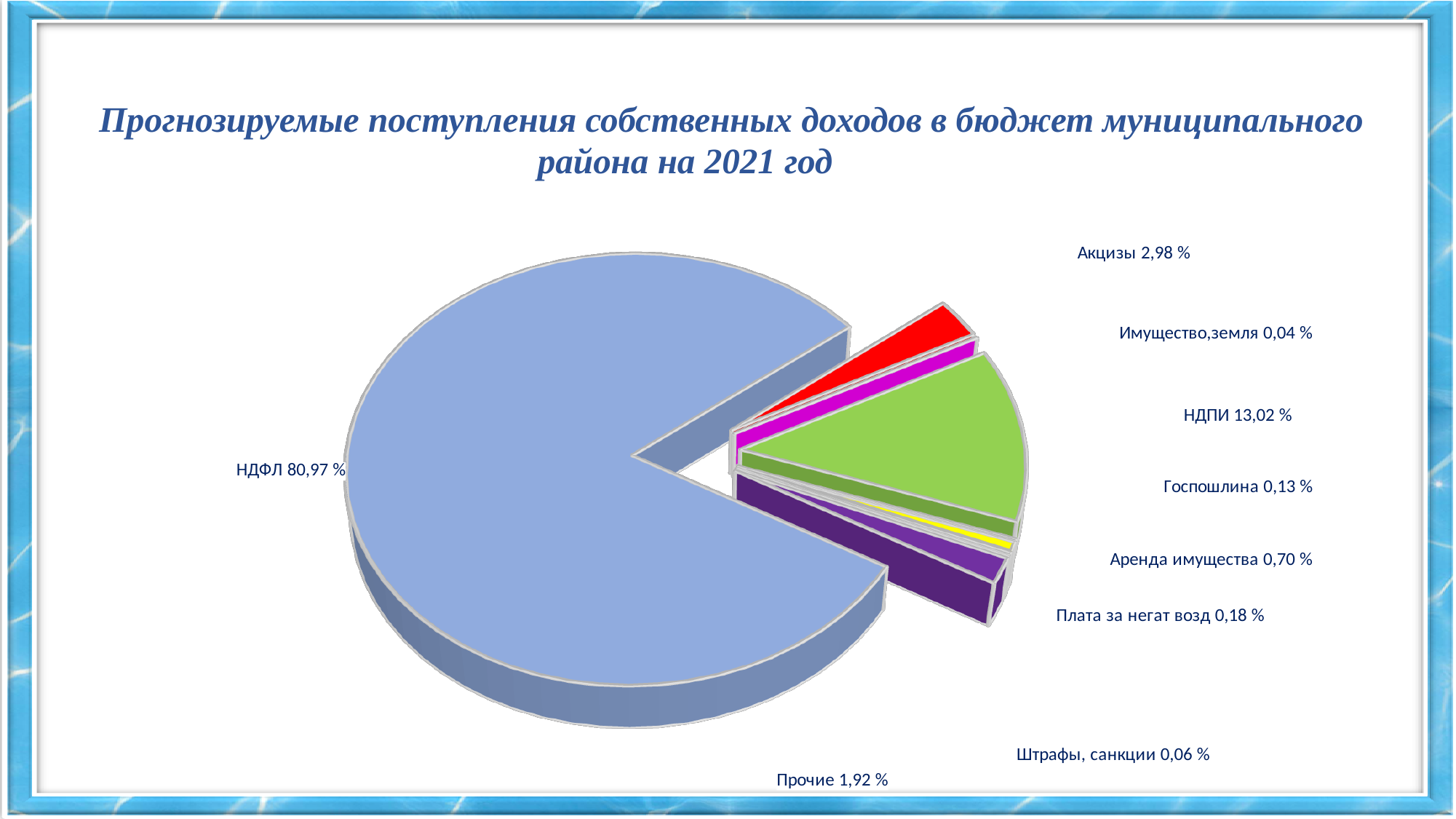
What share of the pie does НДФЛ have? 80,97 % What is the title of the chart? Прогнозируемые поступления собственных доходов в бюджет муниципального района на 2021 год How many categories are shown in the pie chart? 9 What is the value shown for Прочие? 1,92 % Which category has the largest share of the pie? НДФЛ What is the value shown for Аренда имущества? 0,70 % What is the value shown for Акцизы? 2,98 % What is the value shown for НДПИ? 13,02 % What is the difference between the shares for НДФЛ and НДПИ? 67,95 % Which category has the smallest share of the pie? Имущество,земля What kind of chart is shown on the slide? pie chart Which is larger, the share for НДПИ or the share for Акцизы? НДПИ